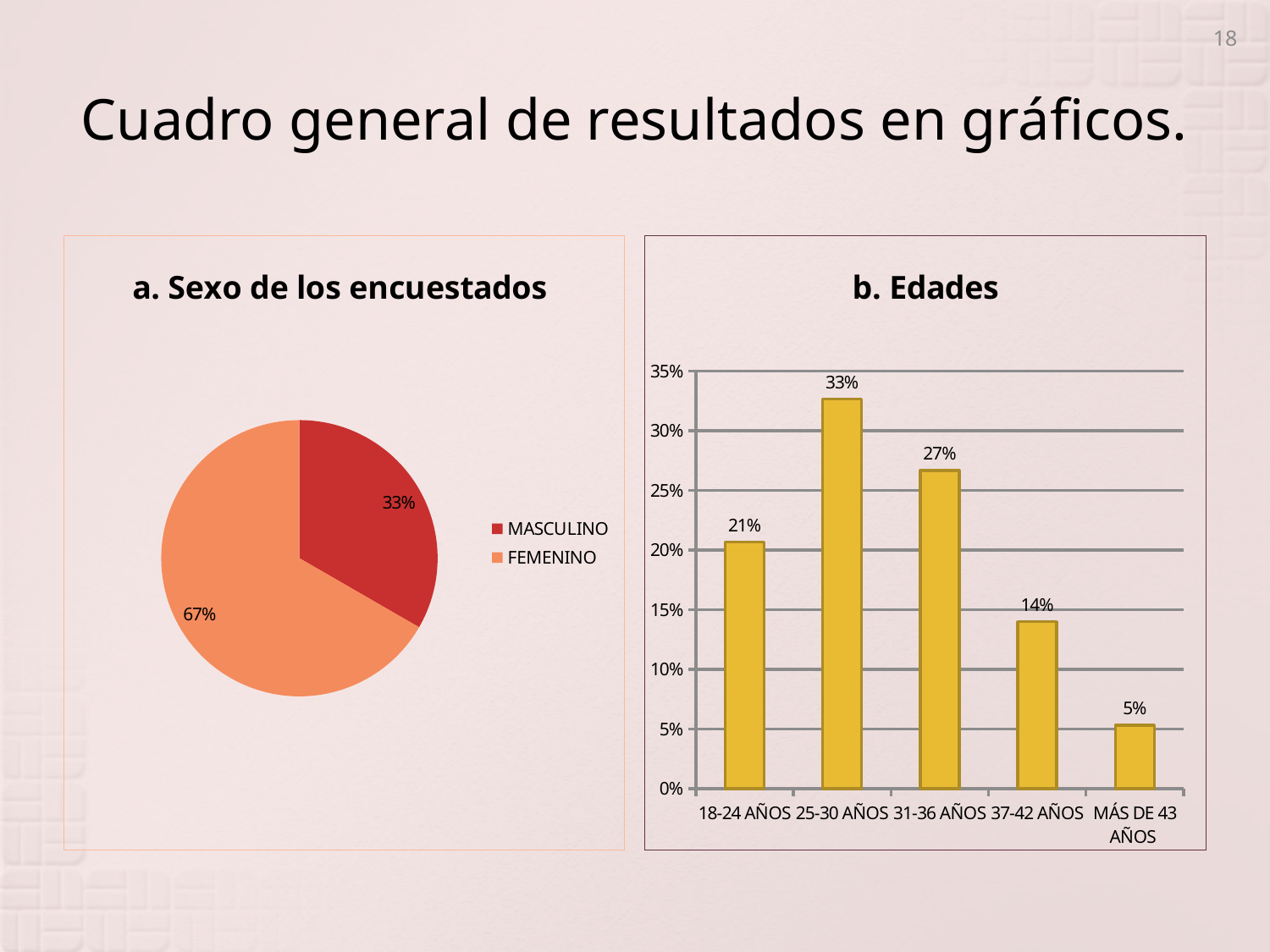
In the chart 'b. Edades', what is the difference between the values for 31-36 AÑOS and 37-42 AÑOS? 13% In the chart 'b. Edades', which is larger, the value for 18-24 AÑOS or the value for 31-36 AÑOS? 31-36 AÑOS In the chart 'b. Edades', which age group has the lowest value? MÁS DE 43 AÑOS In the chart 'b. Edades', what is the value for 25-30 AÑOS? 33% In the chart 'a. Sexo de los encuestados', how many entries does the legend list? 2 What kind of chart is 'b. Edades'? Bar chart In the chart 'b. Edades', what is the value for MÁS DE 43 AÑOS? 5% In the chart 'a. Sexo de los encuestados', what share of respondents is FEMENINO? 67% In the chart 'b. Edades', how many age groups are shown on the x axis? 5 What kind of chart is 'a. Sexo de los encuestados'? Pie chart In the chart 'a. Sexo de los encuestados', what share of respondents is MASCULINO? 33% In the chart 'b. Edades', which age group has the highest value? 25-30 AÑOS